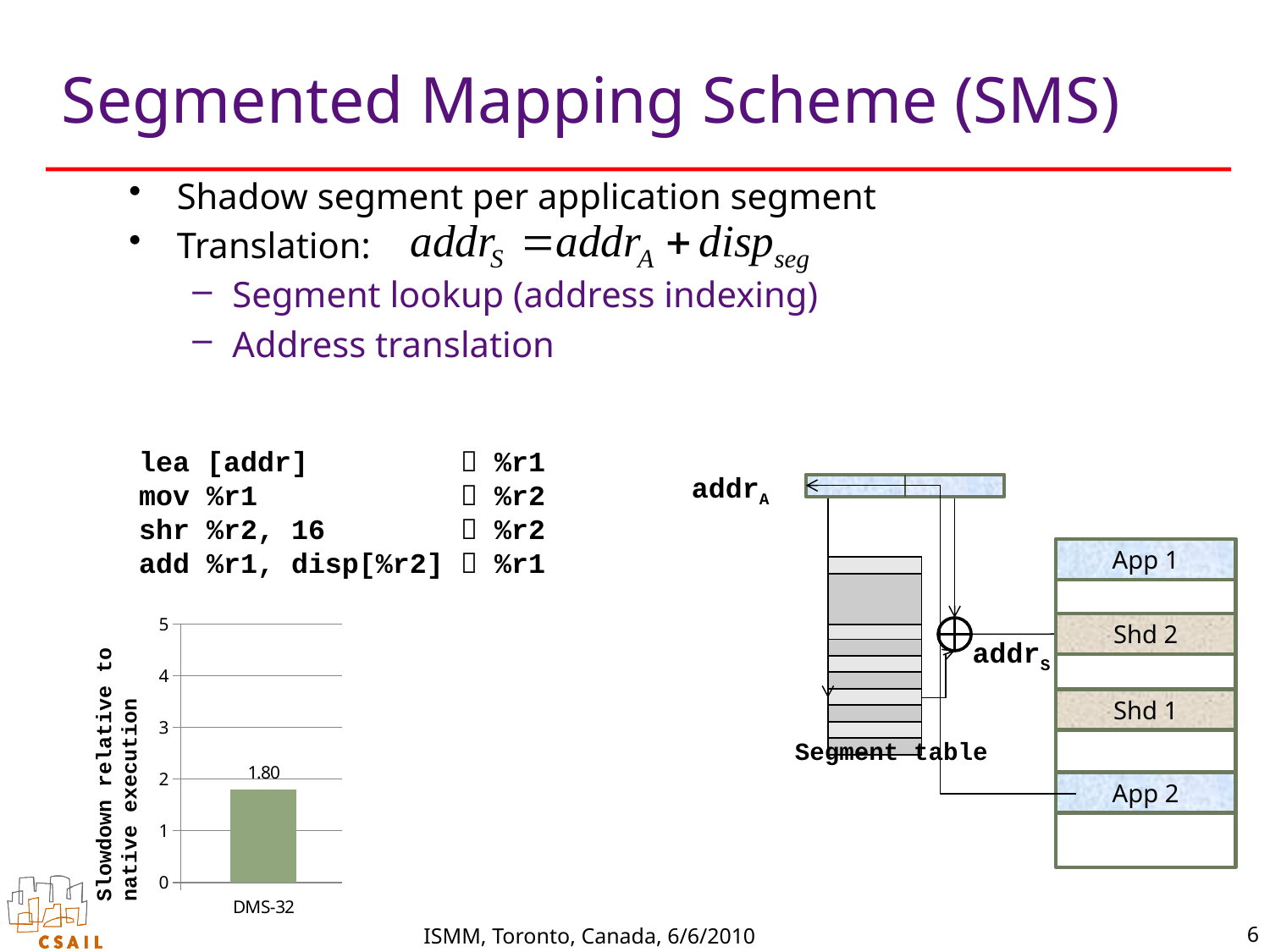
What is the label of the y axis of the chart? Slowdown relative to native execution What is the slowdown relative to native execution for DMS-32? 1.80 How many categories are plotted in the chart? 1 What kind of chart is shown on the slide? bar chart Is the value for DMS-32 greater or less than 1? greater Is the value for DMS-32 greater or less than 2? less What is the name of the only category on the x axis of the chart? DMS-32 What is the maximum value shown on the y axis of the chart? 5